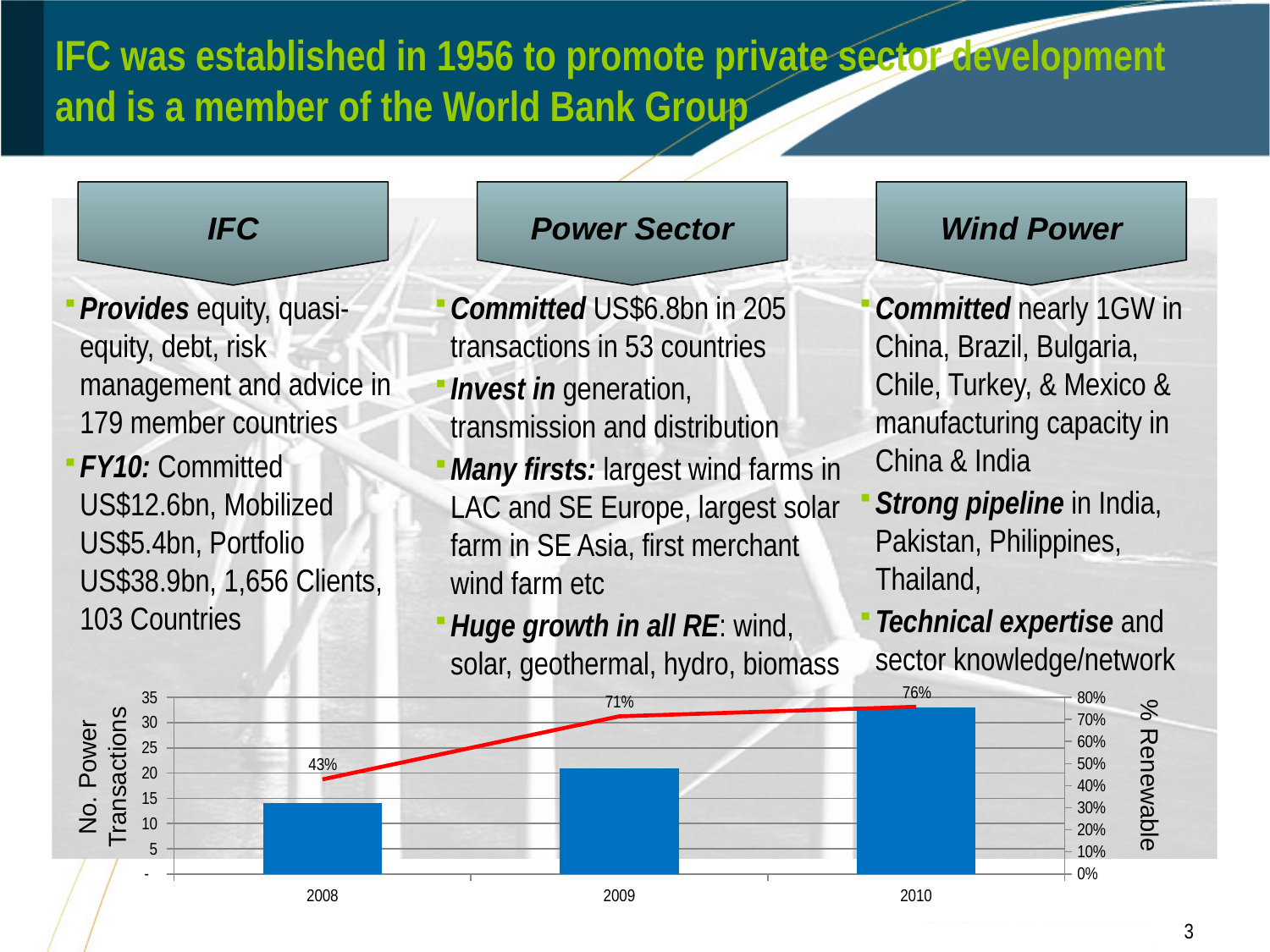
Is the number of power transactions in 2008 greater or less than 20? less Which year has the highest % Renewable value? 2010 By how many percentage points did % Renewable increase from 2008 to 2010? 33 percentage points What is the % Renewable value shown for 2008? 43% What is the title of the right-hand vertical axis of the chart? % Renewable Which year had more power transactions, 2009 or 2010? 2010 Is the number of power transactions in 2010 greater or less than 30? greater What is the % Renewable value shown for 2009? 71% Does the number of power transactions rise or fall from 2008 to 2010? rise What is the % Renewable value shown for 2010? 76% How many years are shown on the x axis of the chart? 3 Which year has the lowest number of power transactions? 2008